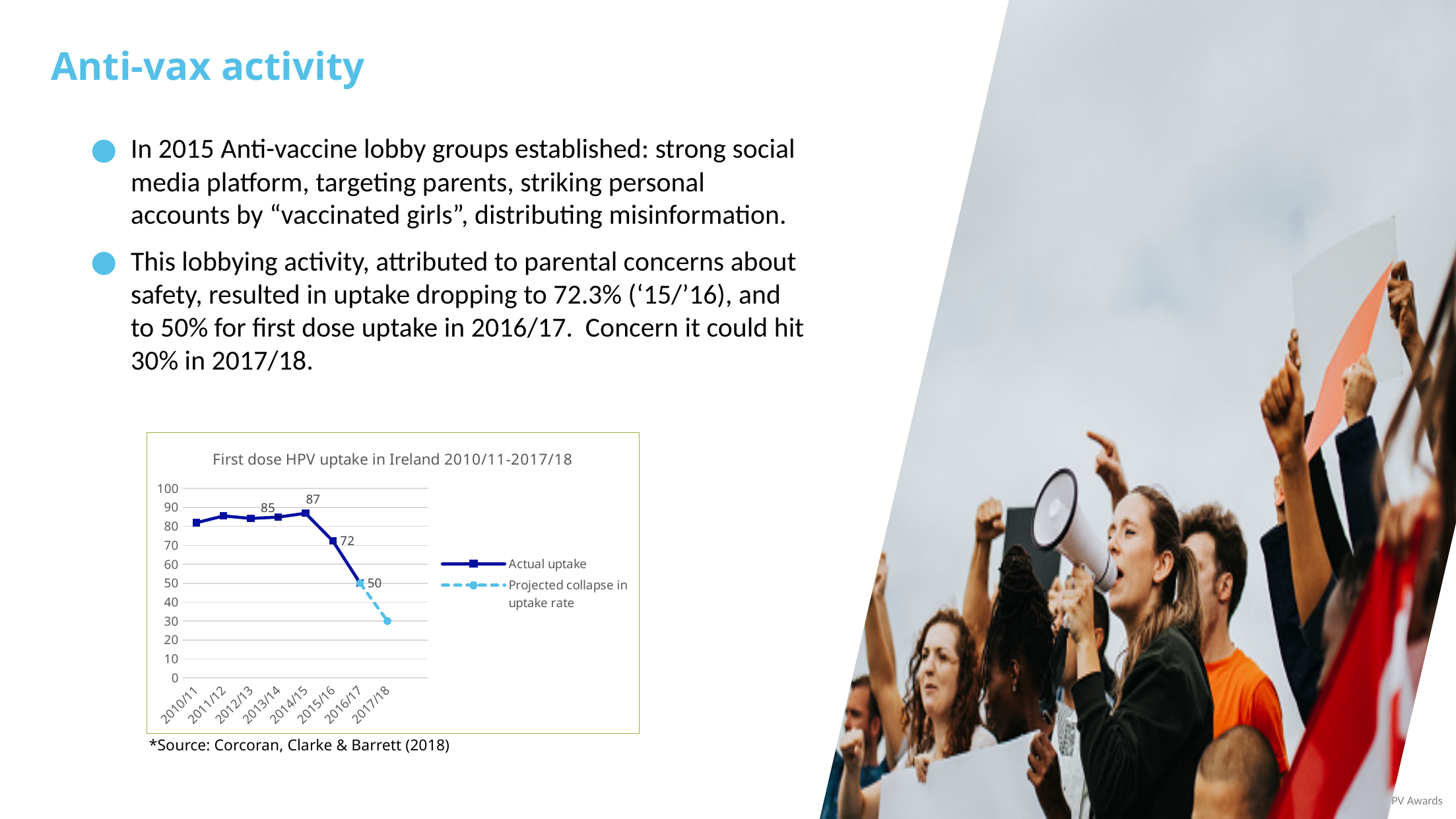
Is the projected value for 2017/18 greater or less than 40? less What kind of chart is shown on the slide? line chart Which year has the highest first dose HPV uptake? 2014/15 What is the difference between the uptake in 2014/15 and 2015/16? 15 Which year has the lowest value on the chart? 2017/18 Which is larger, the uptake in 2015/16 or in 2016/17? 2015/16 How many years are shown on the x axis? 8 What is the actual uptake value for 2015/16? 72 What is the difference between the uptake in 2015/16 and 2016/17? 22 How many series does the legend list? 2 What is the actual uptake value for 2014/15? 87 What is the actual uptake value for 2016/17? 50